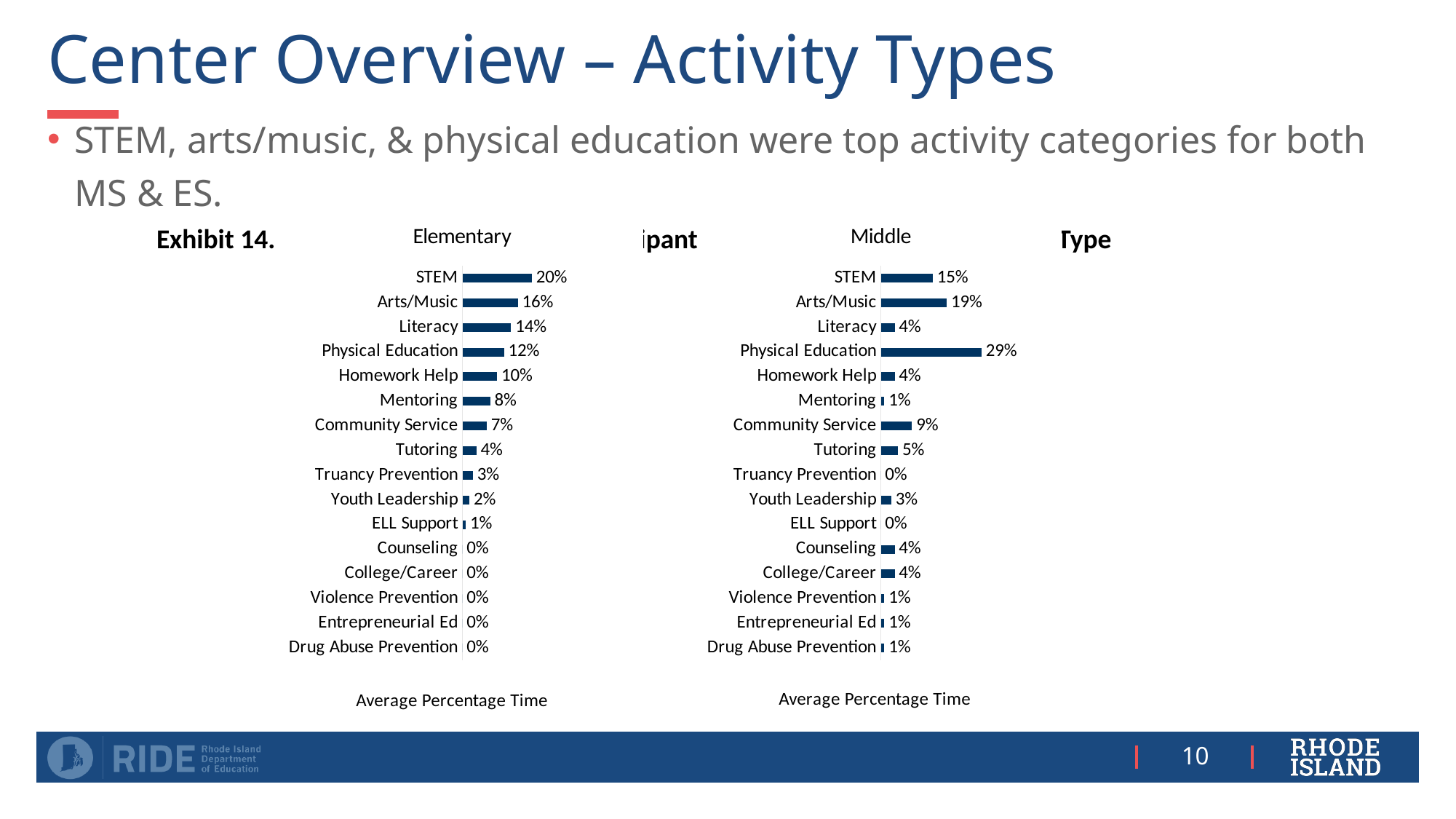
In the Middle chart, what is the difference between Physical Education and STEM? 14% In the Middle chart, what is the value for Arts/Music? 19% In the Middle chart, which category has the highest value? Physical Education In the Elementary chart, what is the value for STEM? 20% In the Elementary chart, what is the value for Homework Help? 10% How many categories are shown in the Elementary chart? 16 In the Middle chart, which is larger, Community Service or Tutoring? Community Service What kind of chart is the Middle chart? Bar chart In the Elementary chart, which category has the highest value? STEM In the Elementary chart, what is the difference between STEM and Arts/Music? 4% In the Middle chart, what is the value for Physical Education? 29% In the Elementary chart, which is larger, Literacy or Physical Education? Literacy